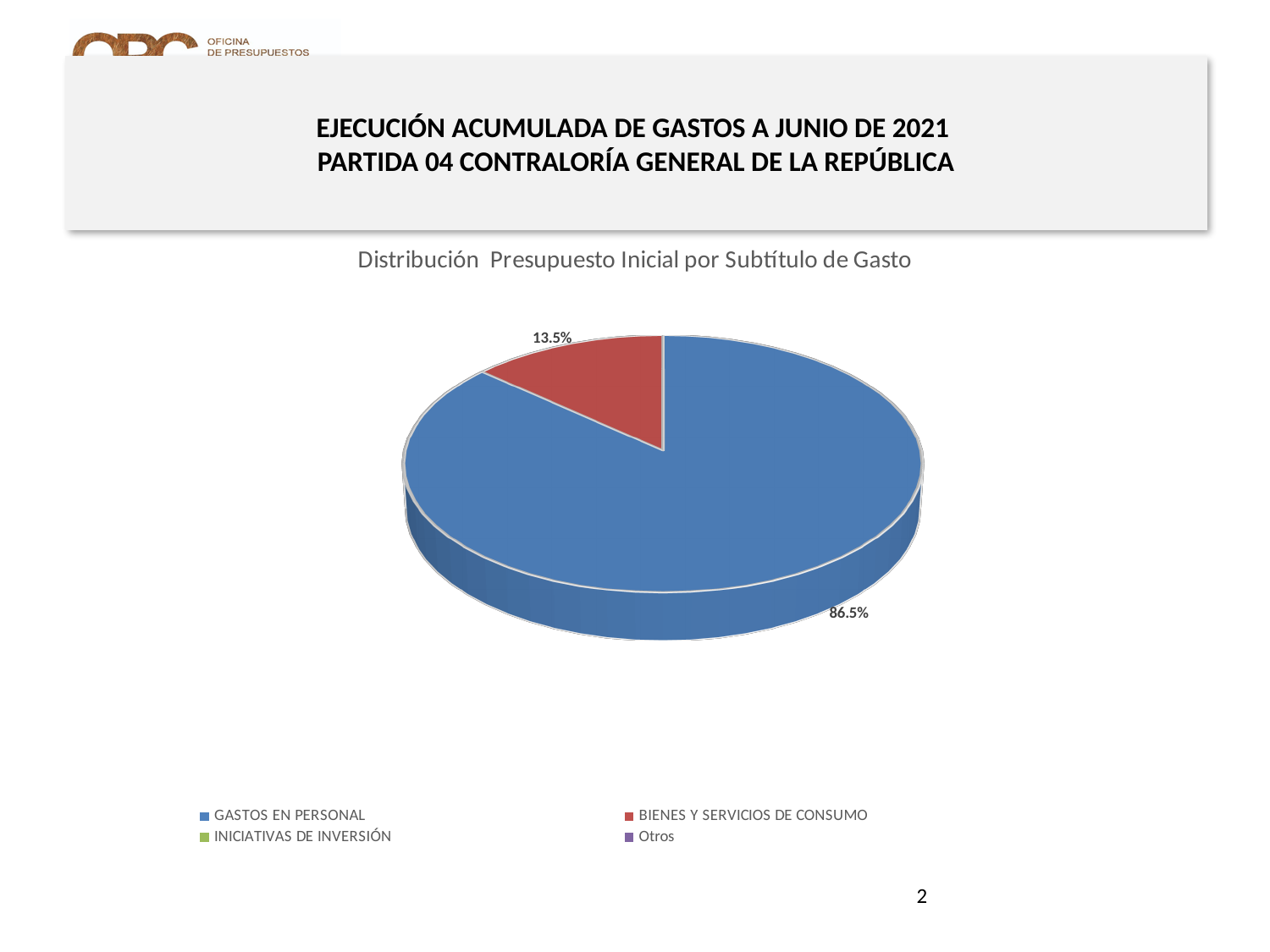
Which is larger, the slice for GASTOS EN PERSONAL or the slice for BIENES Y SERVICIOS DE CONSUMO? GASTOS EN PERSONAL What share of the pie does BIENES Y SERVICIOS DE CONSUMO represent? 13.5% How many entries does the legend list? 4 Which category has the largest slice of the pie? GASTOS EN PERSONAL What is the difference in percentage points between GASTOS EN PERSONAL and BIENES Y SERVICIOS DE CONSUMO? 73.0 How many slices with data labels are visible in the pie? 2 What share of the pie does GASTOS EN PERSONAL represent? 86.5% What is the value shown for the blue slice? 86.5% What kind of chart is shown on the slide? Pie chart What colour is the slice for BIENES Y SERVICIOS DE CONSUMO? Red Which of the labelled slices is the smallest? BIENES Y SERVICIOS DE CONSUMO What is the title of the chart? Distribución Presupuesto Inicial por Subtítulo de Gasto